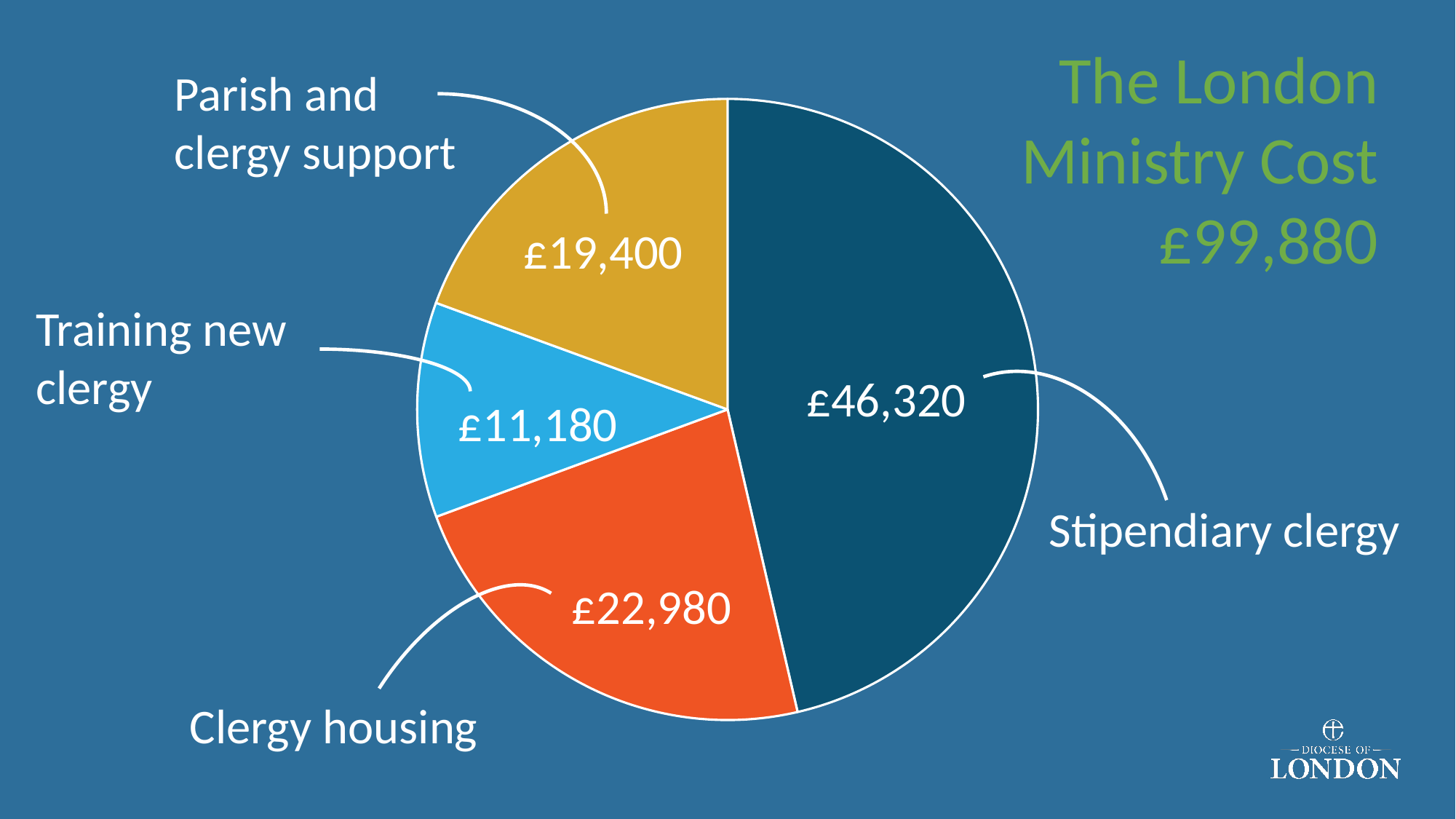
How many categories are shown in the pie chart? 4 What is the difference between the Stipendiary clergy value and the Clergy housing value? £23,340 What is the difference between the Parish and clergy support value and the Training new clergy value? £8,220 What total cost is stated in the chart title? £99,880 What is the value for Stipendiary clergy? £46,320 What kind of chart is shown on the slide? Pie chart What is the value for Clergy housing? £22,980 Which category has the largest slice of the pie? Stipendiary clergy Which category has the smallest slice of the pie? Training new clergy What is the value for Training new clergy? £11,180 What is the value for Parish and clergy support? £19,400 Which is larger, Clergy housing or Parish and clergy support? Clergy housing